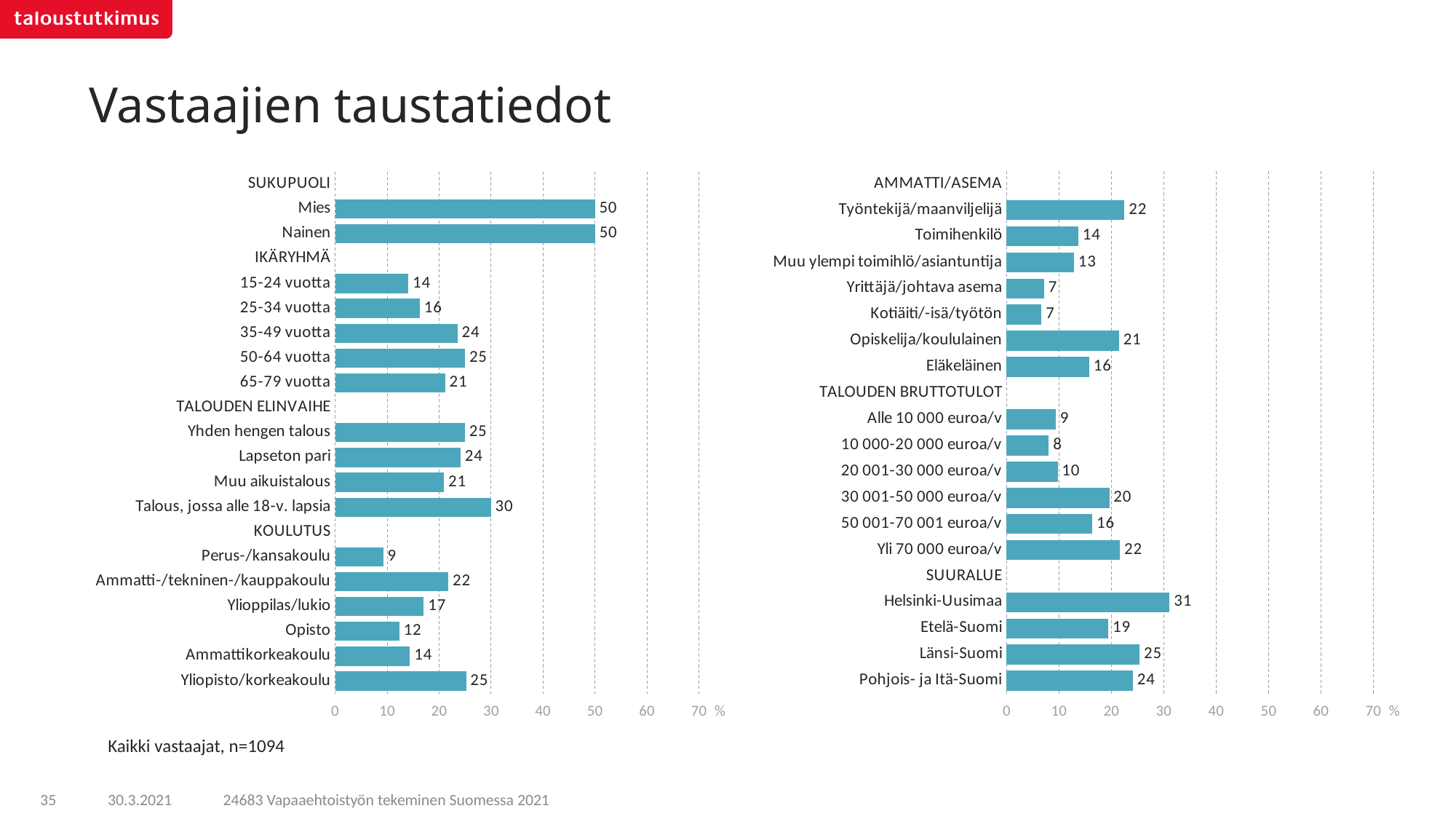
In the right chart, what is the difference between Helsinki-Uusimaa and Pohjois- ja Itä-Suomi? 7 In the right chart, what is the value for Yli 70 000 euroa/v? 22 In the left chart, what is the value for Talous, jossa alle 18-v. lapsia? 30 In the right chart, what is the value for Opiskelija/koululainen? 21 In the left chart, what is the value for 35-49 vuotta? 24 In the right chart, which SUURALUE category has the highest value? Helsinki-Uusimaa What type of chart is shown on the left side of the slide? Bar chart In the right chart, which is larger, Länsi-Suomi or Etelä-Suomi? Länsi-Suomi In the left chart, what is the difference between the values for Yliopisto/korkeakoulu and Opisto? 13 In the left chart, what is the value for Mies? 50 In the left chart, which KOULUTUS category has the lowest value? Perus-/kansakoulu In the right chart, which AMMATTI/ASEMA category has the highest value? Työntekijä/maanviljelijä